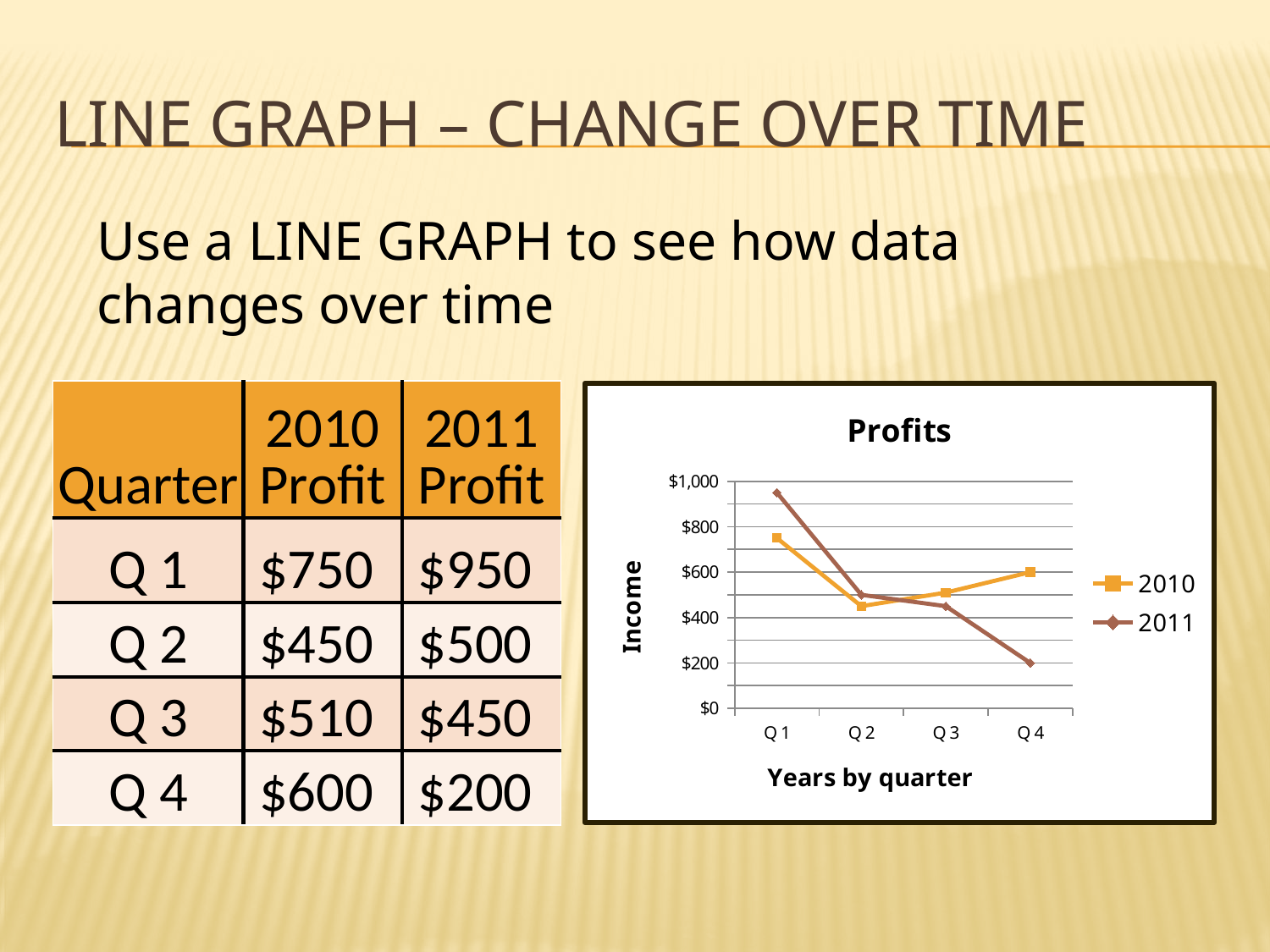
Which quarter has the lowest 2010 profit? Q 2 Is the 2011 value for Q 1 greater or less than $800? greater What kind of chart is shown on the slide? line chart How many quarters are plotted along the x axis of the chart? 4 What is the 2010 profit for Q 1? $750 What is the 2011 profit for Q 4? $200 What is the title of the chart? Profits How many series does the chart legend list? 2 Which quarter has the highest 2011 profit? Q 1 In Q 4, which series has the larger value, 2010 or 2011? 2010 What is the difference between the 2011 and 2010 profit in Q 1? $200 Does the 2011 series rise or fall from Q 1 to Q 4? fall